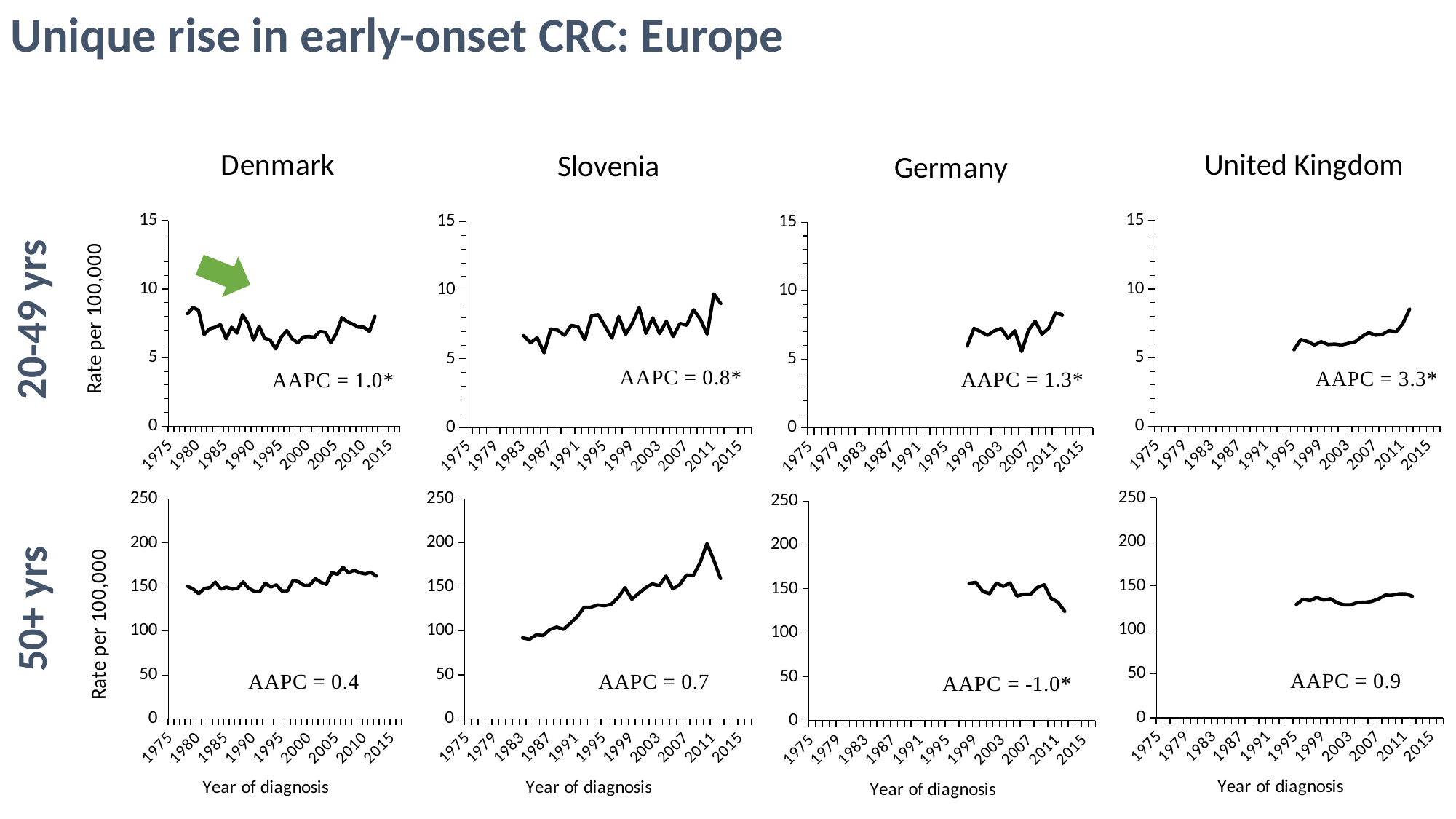
In the Slovenia 50+ yrs chart, does the rate generally rise or fall from 1983 to 2011? rise Among the four 20-49 yrs charts, which country has the highest printed AAPC? United Kingdom What type of chart is used for the Denmark 20-49 yrs panel? line chart In the Slovenia 50+ yrs chart, what is the AAPC value printed? AAPC = 0.7 In the Germany 50+ yrs chart, what is the AAPC value printed? AAPC = -1.0* In the Slovenia 50+ yrs chart, is the rate in 1983 greater or less than 100? less What is the y-axis label on the 50+ yrs charts? Rate per 100,000 In the United Kingdom 20-49 yrs chart, what is the AAPC value printed? AAPC = 3.3* Among the four 50+ yrs charts, which country has the lowest printed AAPC? Germany In the Germany 50+ yrs chart, does the rate generally rise or fall from 1999 to 2013? fall How many charts are shown on the slide? 8 In the Germany 20-49 yrs chart, is the rate in 2013 greater or less than 10? less